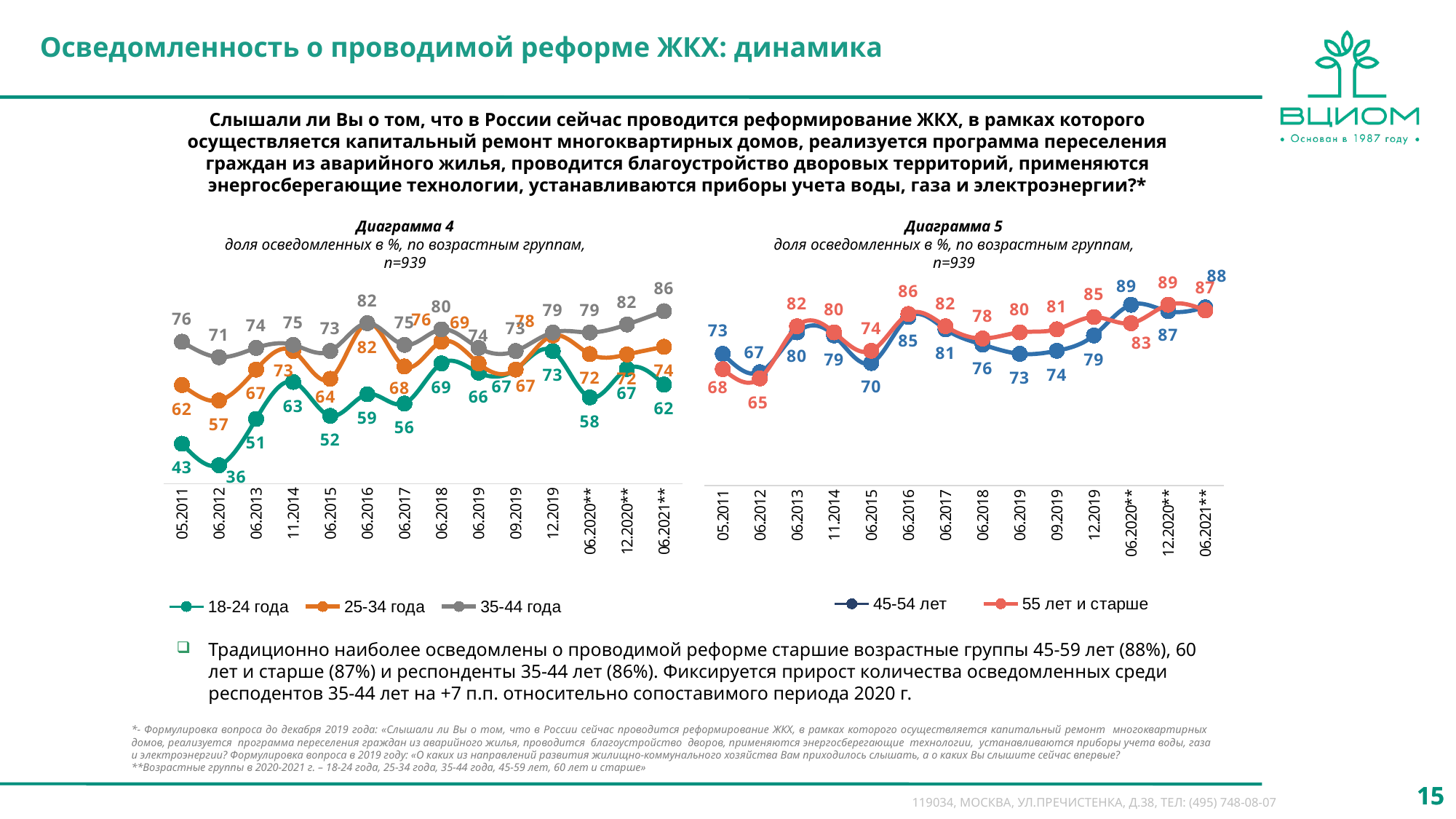
On Диаграмма 4, at which date is the 18-24 года series lowest? 06.2012 On Диаграмма 5, at which date is the 45-54 лет series highest? 06.2020** On Диаграмма 5, which series has the larger value at 09.2019: 45-54 лет or 55 лет и старше? 55 лет и старше On Диаграмма 5, what is the difference between the 55 лет и старше and 45-54 лет values at 06.2019? 7 On Диаграмма 4, what is the value for the 18-24 года series at 05.2011? 43 On Диаграмма 5, how many dates are shown on the x axis? 14 On Диаграмма 5, what is the value for the 55 лет и старше series at 06.2012? 65 On Диаграмма 4, how many series does the legend list? 3 On Диаграмма 4, what is the value for the 35-44 года series at 06.2021**? 86 On Диаграмма 4, what is the difference between the 35-44 года and 18-24 года values at 06.2021**? 24 What kind of chart is Диаграмма 4? Line chart On Диаграмма 4, does the 35-44 года series rise or fall from 06.2020** to 06.2021**? Rise